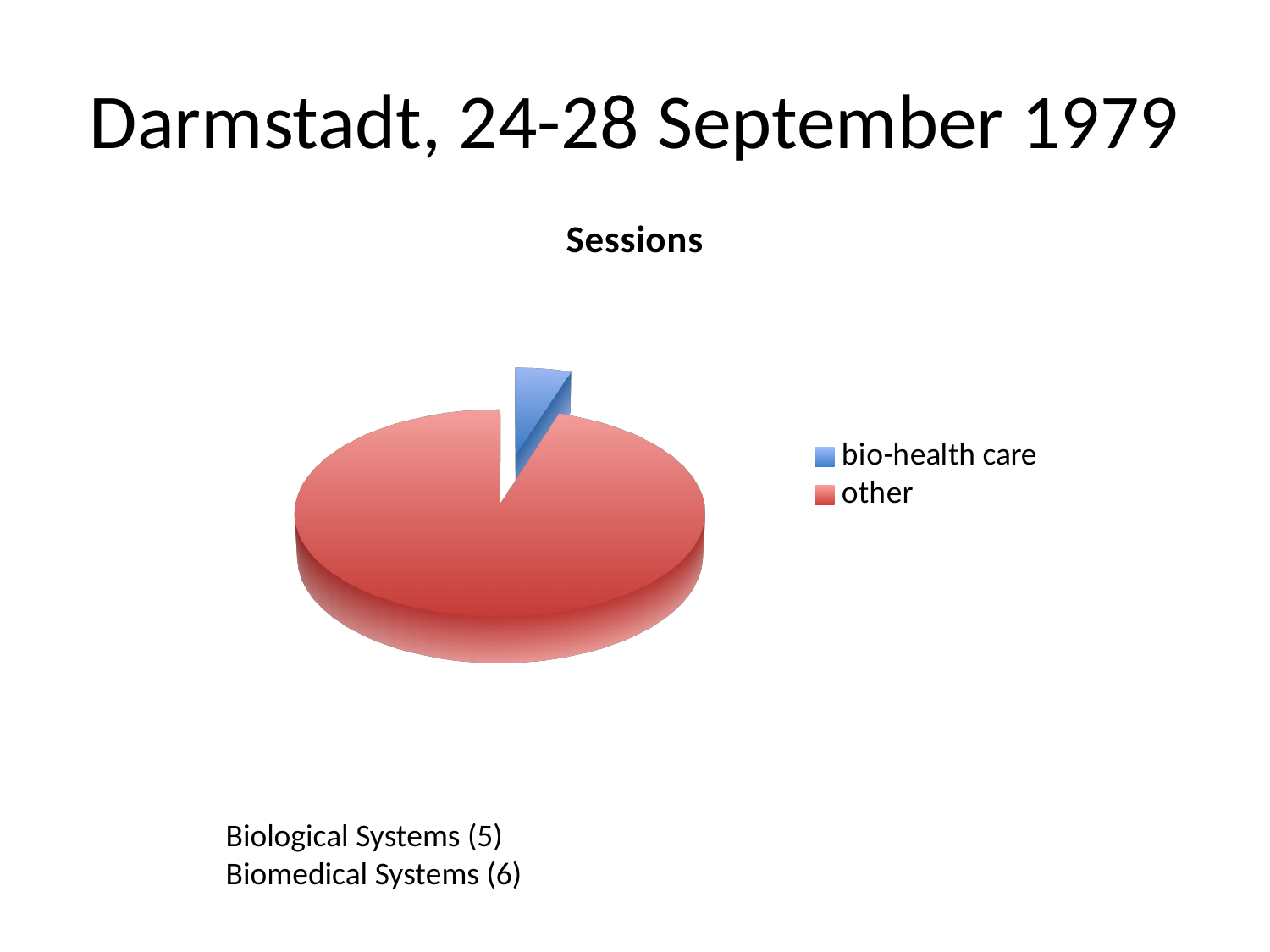
How many slices does the pie chart have? 2 What is the title of the chart? Sessions Which slice of the pie is the largest? other How many entries does the legend list? 2 Which slice of the pie is the smallest? bio-health care What kind of chart is shown on the slide? pie chart Which is larger, the bio-health care slice or the other slice? other What colour is the bio-health care slice? blue